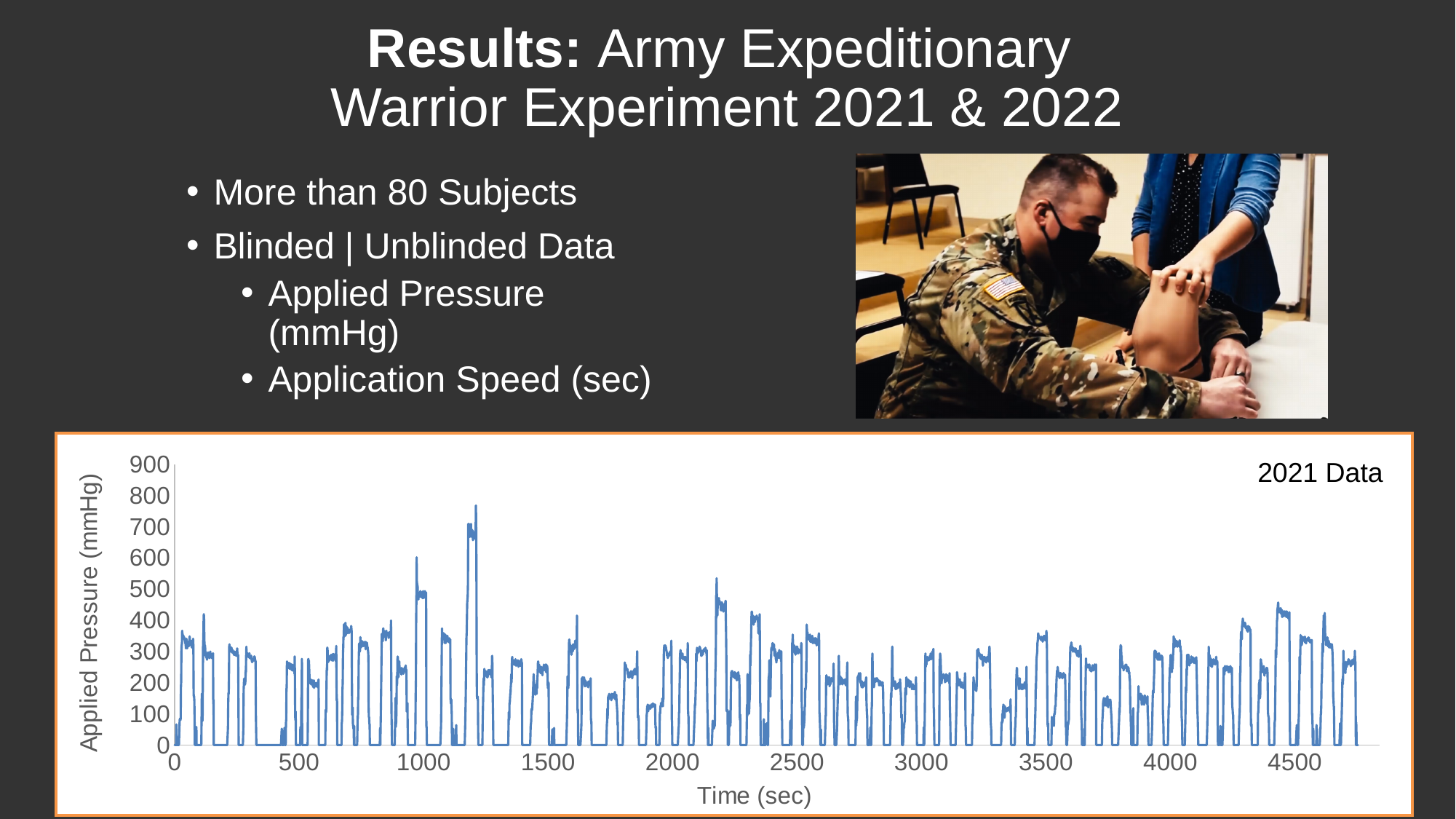
What kind of chart is shown on the slide? line chart Around which time on the x-axis does the applied pressure reach its highest peak: near 1200 seconds or near 2200 seconds? near 1200 seconds Is the peak applied pressure near 2200 seconds greater or less than 600 mmHg? less What is the highest tick value shown on the y-axis of the chart? 900 Is the peak applied pressure near 1000 seconds greater or less than 500 mmHg? greater What is the highest tick value shown on the x-axis of the chart? 4500 Is the peak applied pressure near 4400 seconds greater or less than 400 mmHg? greater How many data series are plotted in the chart? 1 What year's data does the chart's annotation say is plotted? 2021 Data What is the label on the y-axis of the chart? Applied Pressure (mmHg)